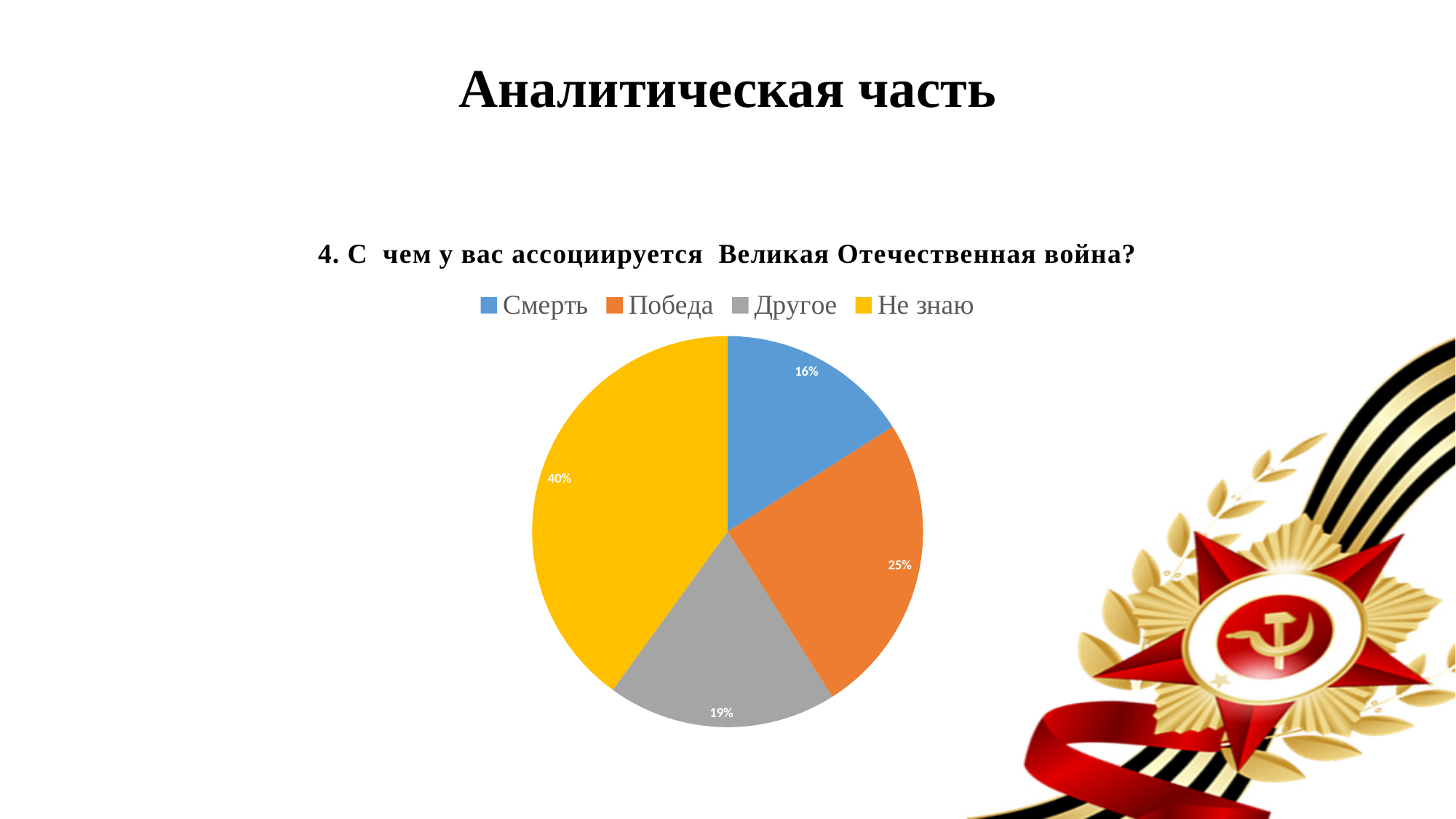
How many categories does the legend list? 4 What is the difference in percentage points between Не знаю and Победа? 15 What percentage of the pie is labelled for Смерть? 16% Which category has the smallest slice of the pie? Смерть What percentage of the pie is labelled for Не знаю? 40% Which is larger, the slice for Победа or the slice for Другое? Победа What percentage of the pie is labelled for Победа? 25% What percentage of the pie is labelled for Другое? 19% What type of chart is shown on the slide? pie chart What is the title of the chart? 4. С чем у вас ассоциируется Великая Отечественная война? Which category has the largest slice of the pie? Не знаю What colour is the slice for Не знаю? yellow